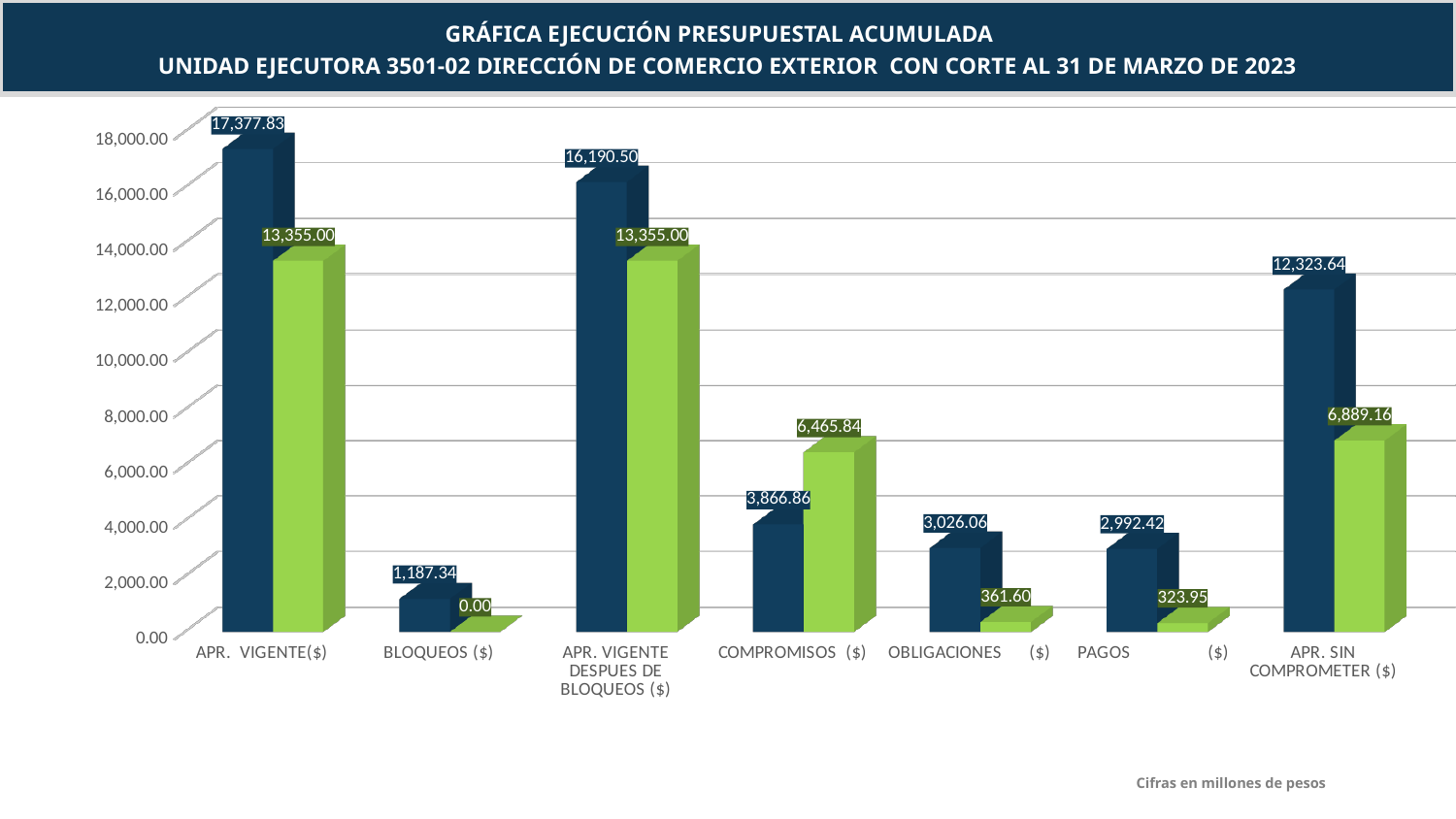
What is the value of the green bar for PAGOS ($)? 323.95 For COMPROMISOS ($), which bar is larger, the dark blue one or the green one? the green one What is the value of the dark blue bar for APR. VIGENTE($)? 17,377.83 What kind of chart is shown on the slide? bar chart What is the difference between the dark blue bar and the green bar for APR. SIN COMPROMETER ($)? 5,434.48 Which category has the highest dark blue bar? APR. VIGENTE($) What is the value of the dark blue bar for BLOQUEOS ($)? 1,187.34 What is the value of the green bar for COMPROMISOS ($)? 6,465.84 Which category has the lowest green bar? BLOQUEOS ($) According to the note on the slide, in what units are the figures expressed? millones de pesos How many categories are shown on the x axis? 7 What is the difference between the dark blue bar and the green bar for APR. VIGENTE($)? 4,022.83